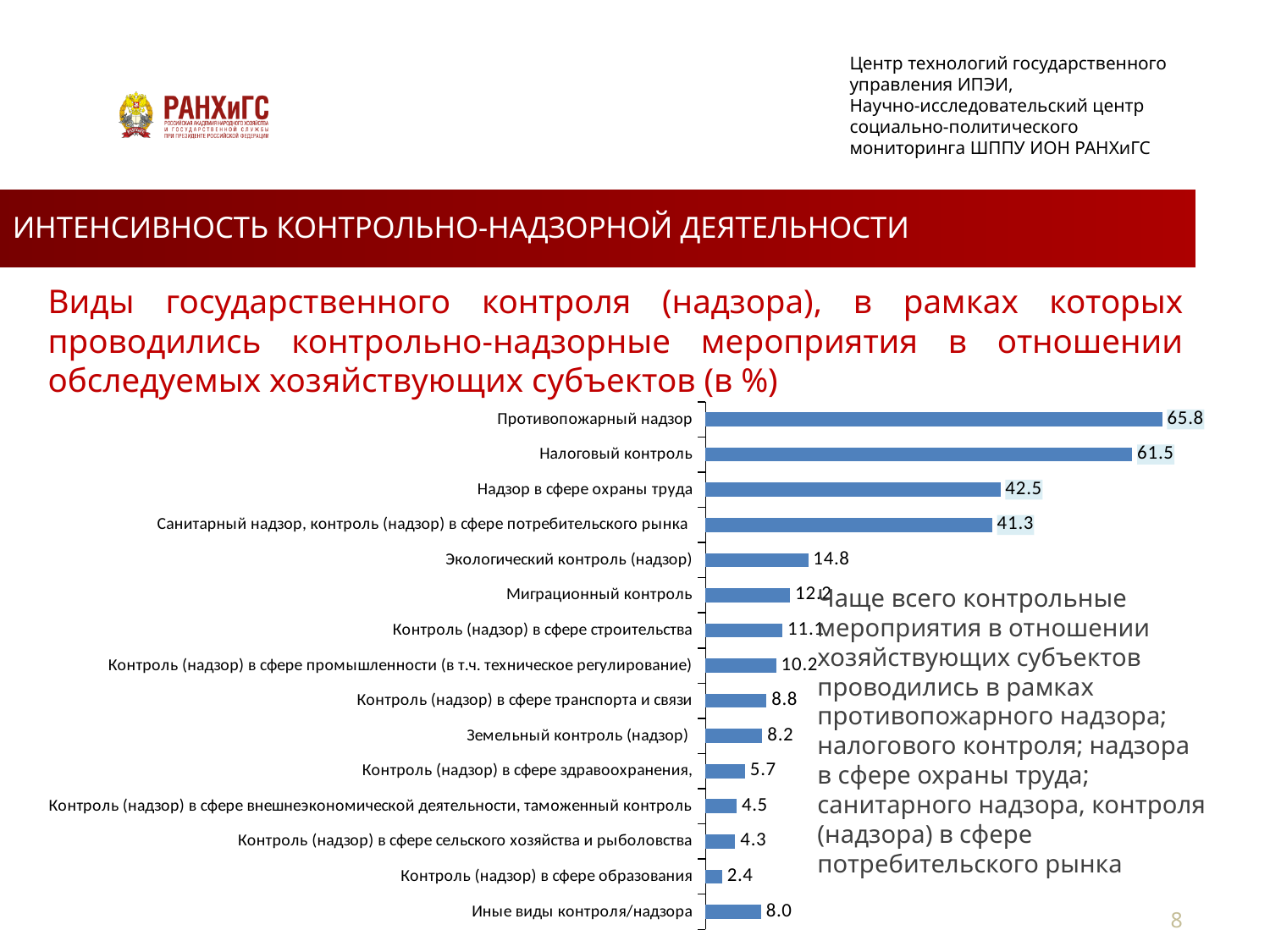
What is the value for Иные виды контроля/надзора? 8.0 Which category has the highest value? Противопожарный надзор What is the value for Контроль (надзор) в сфере образования? 2.4 What is the value for Противопожарный надзор? 65.8 Which category has the lowest value? Контроль (надзор) в сфере образования What is the value for Надзор в сфере охраны труда? 42.5 What is the difference between the values for Противопожарный надзор and Налоговый контроль? 4.3 How many categories are shown in the chart? 15 Which is larger: the value for Земельный контроль (надзор) or the value for Контроль (надзор) в сфере транспорта и связи? Контроль (надзор) в сфере транспорта и связи What is the difference between the values for Надзор в сфере охраны труда and Санитарный надзор, контроль (надзор) в сфере потребительского рынка? 1.2 What type of chart is shown on the slide? bar chart What is the value for Налоговый контроль? 61.5